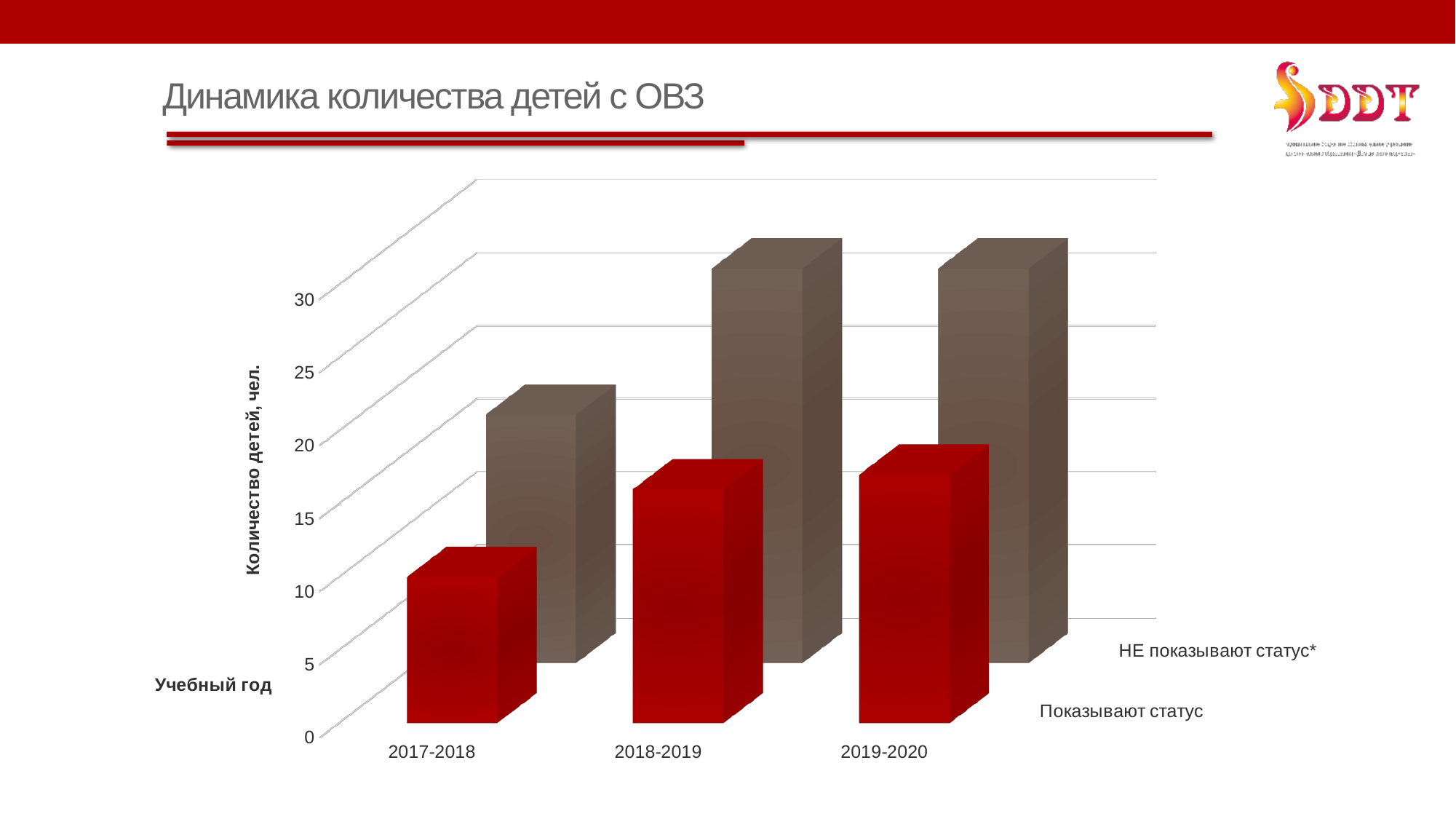
Is the value for 'Показывают статус' in 2017-2018 greater or less than 15? less Is the value for 'НЕ показывают статус*' in 2018-2019 greater or less than 20? greater How many series does the chart show? 2 What is the label of the vertical axis? Количество детей, чел. Do the values for 'Показывают статус' rise or fall from 2017-2018 to 2019-2020? rise What kind of chart is shown on the slide? bar chart For the series 'Показывают статус', which academic year has the lowest value? 2017-2018 Is the value for 'Показывают статус' in 2019-2020 greater or less than 15? greater For the series 'НЕ показывают статус*', which academic year has the lowest value? 2017-2018 In 2018-2019, which series has the larger value: 'Показывают статус' or 'НЕ показывают статус*'? НЕ показывают статус* How many academic years (categories) are shown on the x axis? 3 What is the title of the chart on the slide? Динамика количества детей с ОВЗ